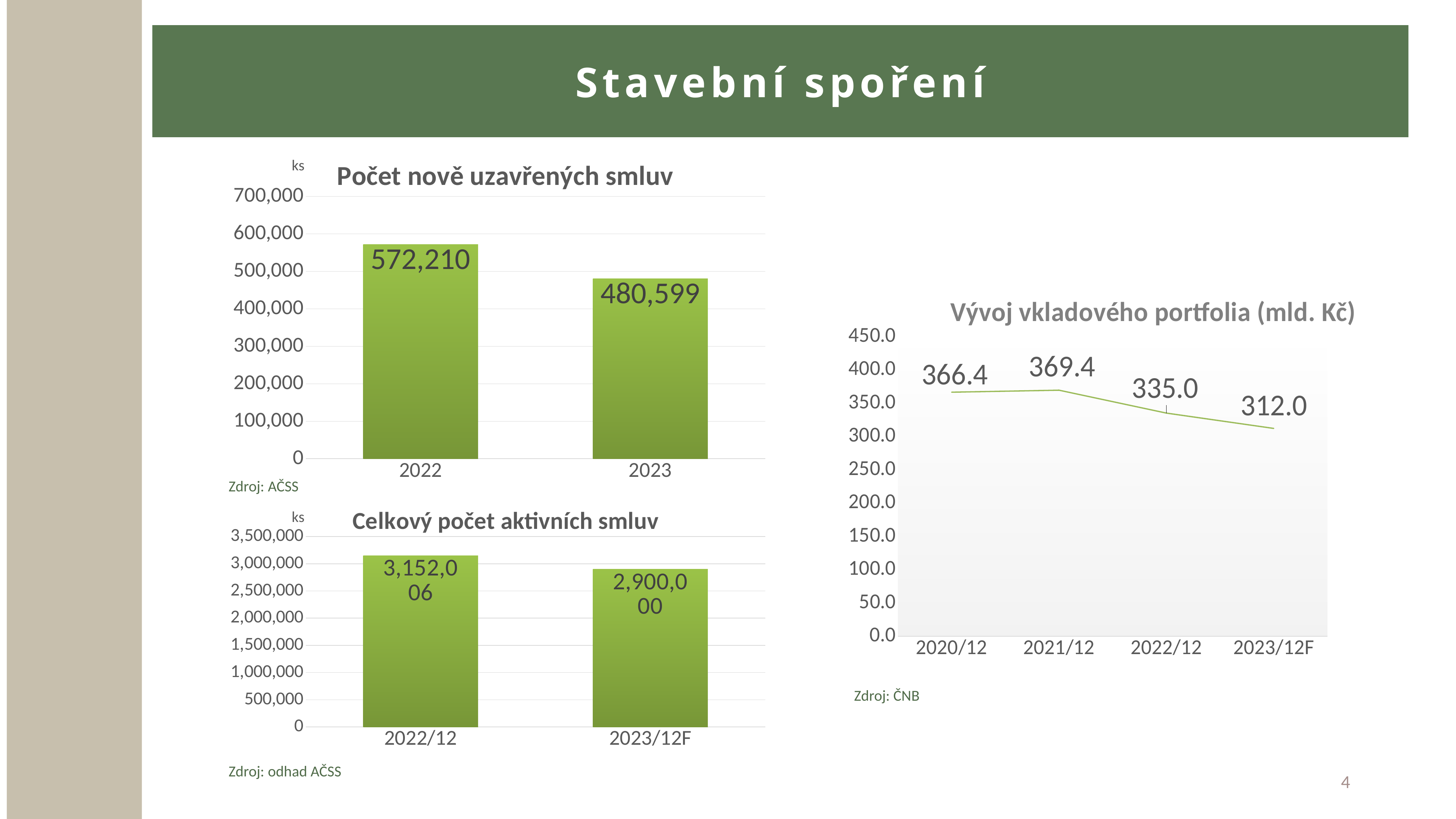
In the chart 'Celkový počet aktivních smluv', which category has the higher value, 2022/12 or 2023/12F? 2022/12 In the chart 'Celkový počet aktivních smluv', what is the value for 2022/12? 3,152,006 In the chart 'Vývoj vkladového portfolia (mld. Kč)', how many data points are plotted? 4 In the chart 'Celkový počet aktivních smluv', what is the value for 2023/12F? 2,900,000 In the chart 'Vývoj vkladového portfolia (mld. Kč)', what is the difference between the 2022/12 and 2023/12F values? 23.0 In the chart 'Vývoj vkladového portfolia (mld. Kč)', what is the value for 2021/12? 369.4 In the chart 'Počet nově uzavřených smluv', what is the difference between the 2022 and 2023 values? 91,611 In the chart 'Počet nově uzavřených smluv', what kind of chart is shown? bar chart In the chart 'Počet nově uzavřených smluv', what is the value for 2023? 480,599 In the chart 'Vývoj vkladového portfolia (mld. Kč)', what kind of chart is shown? line chart In the chart 'Počet nově uzavřených smluv', what is the value for 2022? 572,210 In the chart 'Vývoj vkladového portfolia (mld. Kč)', which period has the lowest value? 2023/12F